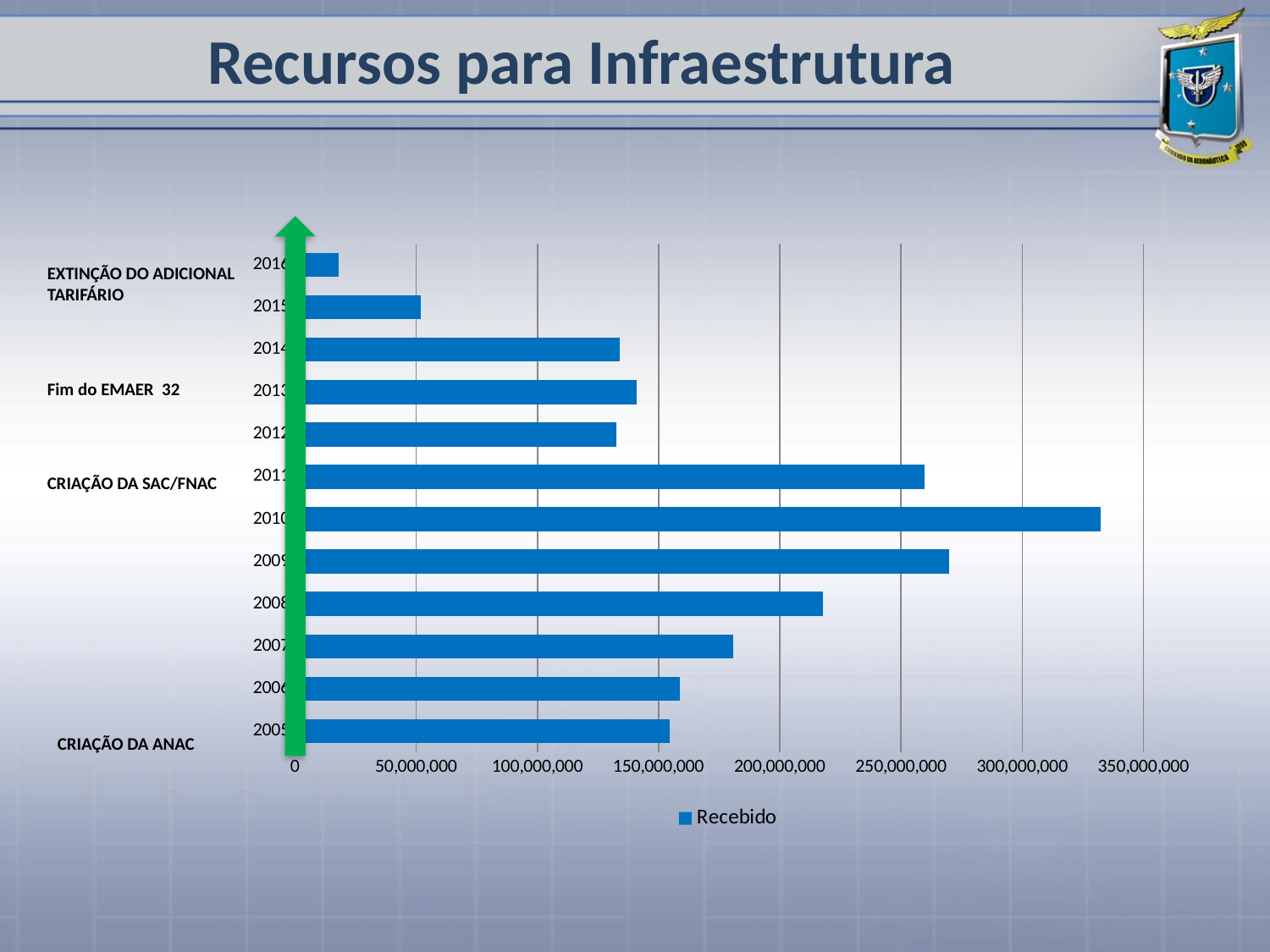
Which is larger, the value for 2015 or the value for 2016? 2015 What kind of chart is shown on the slide? bar chart Which year has the lowest Recebido value? 2016 Which is larger, the value for 2009 or the value for 2008? 2009 How many series does the legend list? 1 Is the value for 2007 greater or less than 200,000,000? less Which year has the highest Recebido value? 2010 Is the value for 2016 greater or less than 50,000,000? less What series name is shown in the chart legend? Recebido Is the value for 2008 greater or less than 200,000,000? greater How many years are plotted on the chart? 12